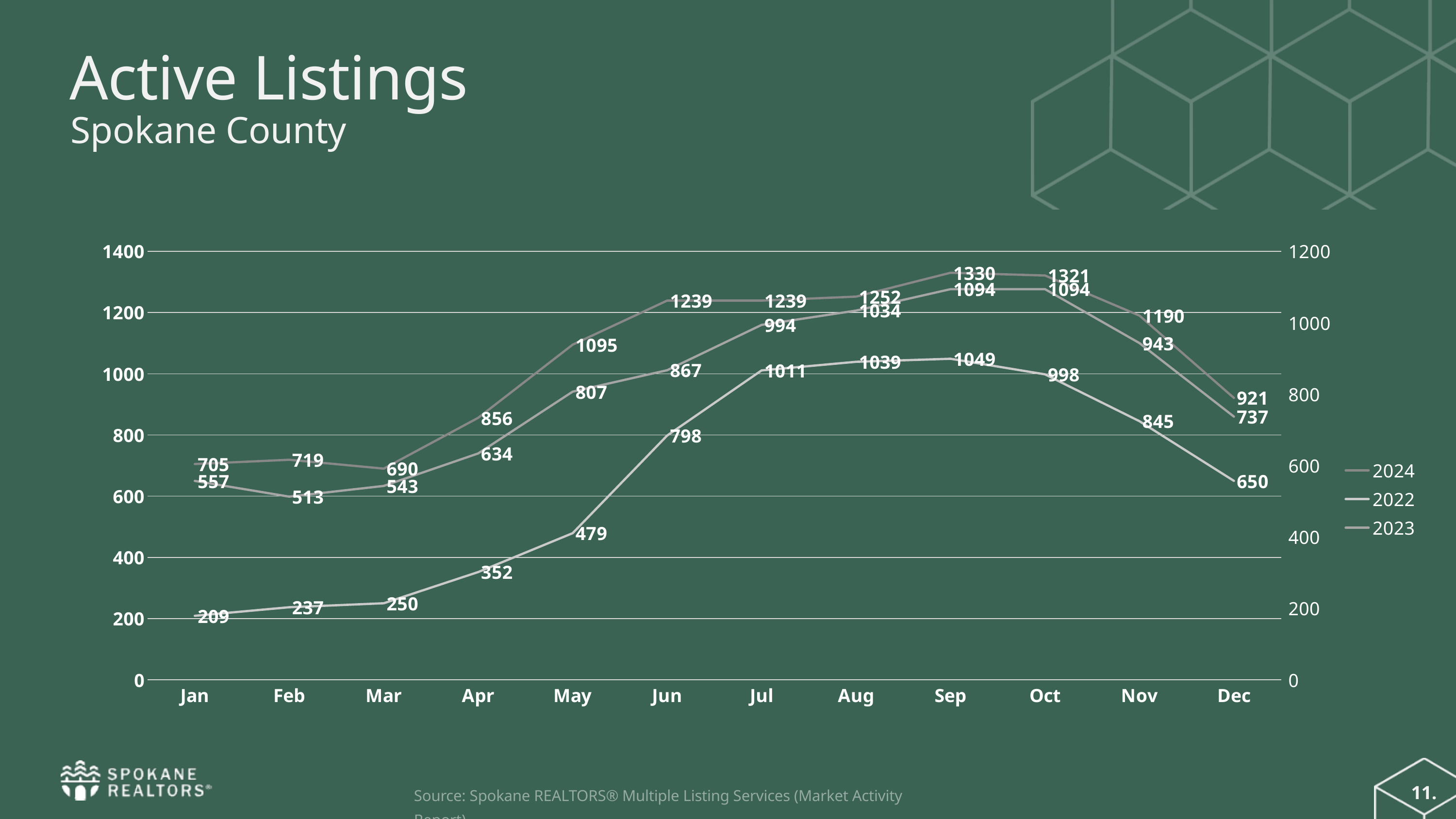
Which is larger, the highest value in Sep or the highest value in Oct? Sep What type of chart is shown on the slide? line chart What is the difference between the highest and lowest values shown for Jan? 496 What is the difference between the highest and lowest values shown for Sep? 281 What is the highest value shown for Sep? 1330 What is the highest value plotted anywhere on the chart? 1330 Does the lowest line rise or fall from Jan to Sep? rises How many series does the legend list? 3 How many months are shown along the x axis? 12 What is the lowest value plotted anywhere on the chart? 209 What is the lowest value shown for Dec? 650 Which years are listed in the legend? 2024, 2022, 2023